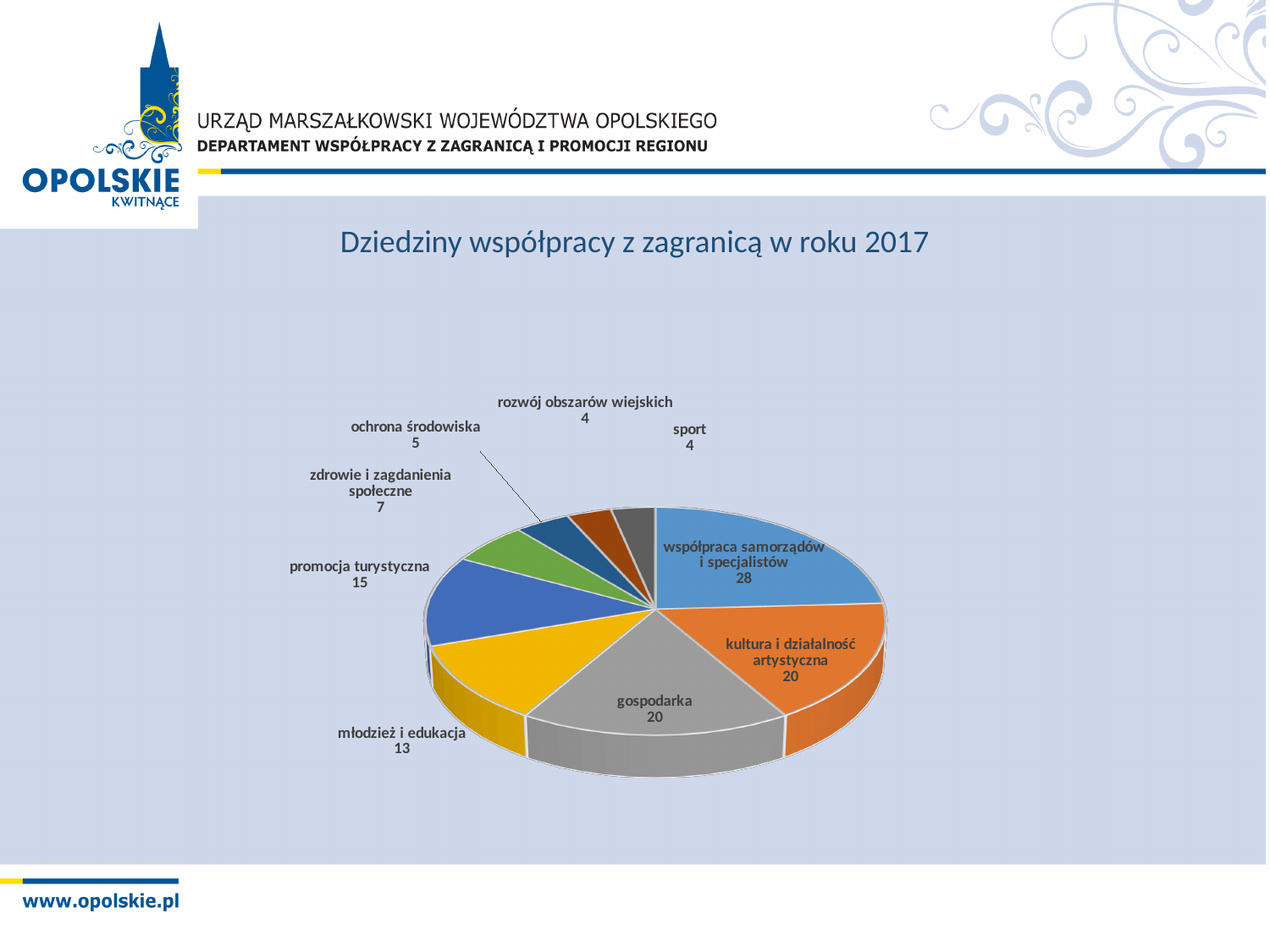
What type of chart is shown on the slide? pie chart What is the difference between the values for 'zdrowie i zagdanienia społeczne' and 'ochrona środowiska'? 2 What is the value for 'młodzież i edukacja'? 13 Which is larger, the value for 'promocja turystyczna' or for 'młodzież i edukacja'? promocja turystyczna What is the value for 'współpraca samorządów i specjalistów'? 28 What is the title of the chart? Dziedziny współpracy z zagranicą w roku 2017 How many categories does the pie chart show? 9 What is the value for 'gospodarka'? 20 What is the difference between the values for 'współpraca samorządów i specjalistów' and 'kultura i działalność artystyczna'? 8 What is the value for 'promocja turystyczna'? 15 What is the value for 'ochrona środowiska'? 5 Which category has the highest value? współpraca samorządów i specjalistów